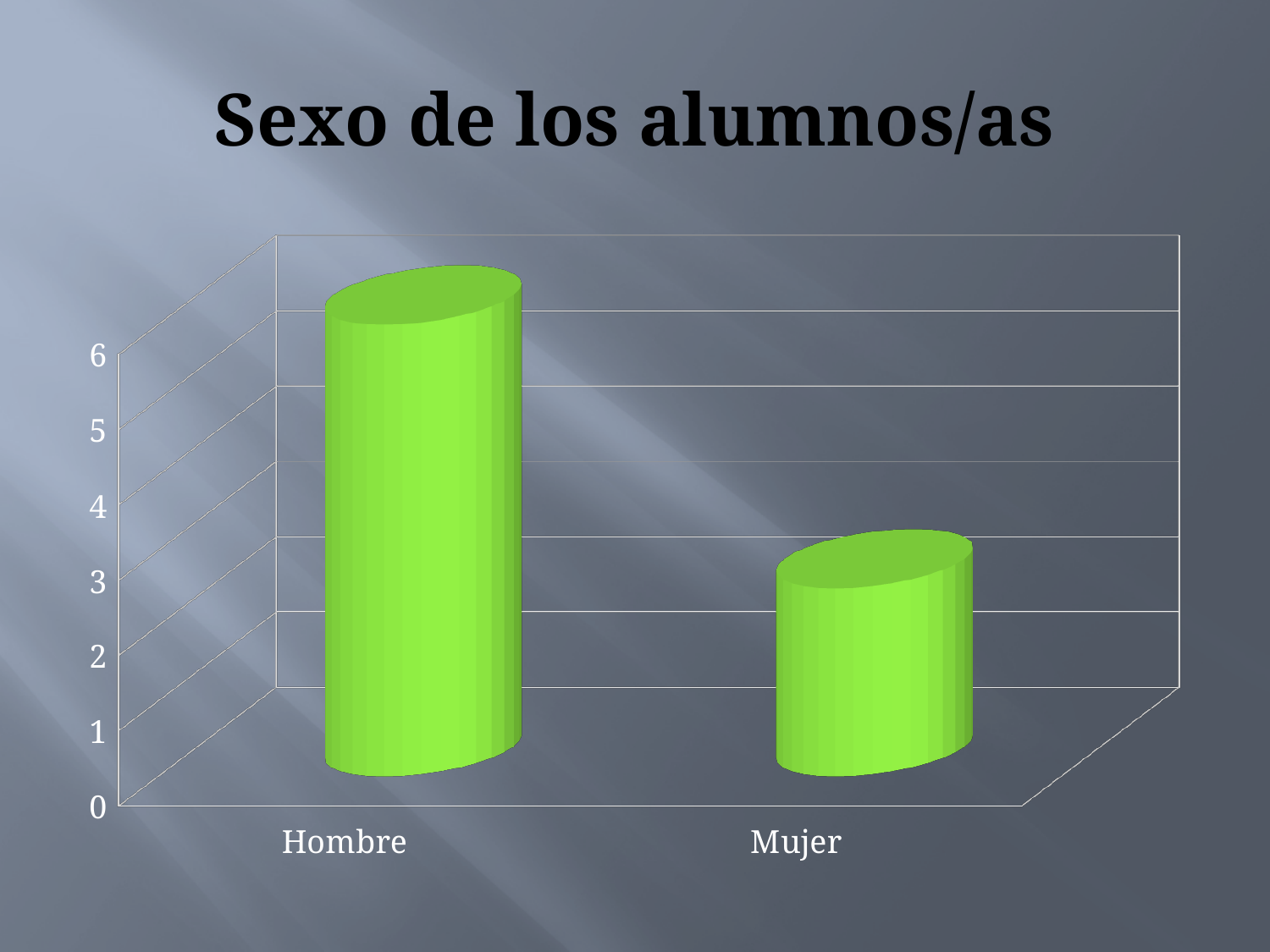
What kind of chart is shown on the slide? bar chart Which category has the highest value? Hombre What is the title of the chart? Sexo de los alumnos/as How many categories are plotted on the chart? 2 Is the value for Mujer greater or less than 5? less Is the value for Mujer greater or less than 1? greater What is the highest value shown on the vertical axis? 6 Which is larger, the value for Hombre or the value for Mujer? Hombre Which category has the lowest value? Mujer Is the value for Hombre greater or less than 4? greater